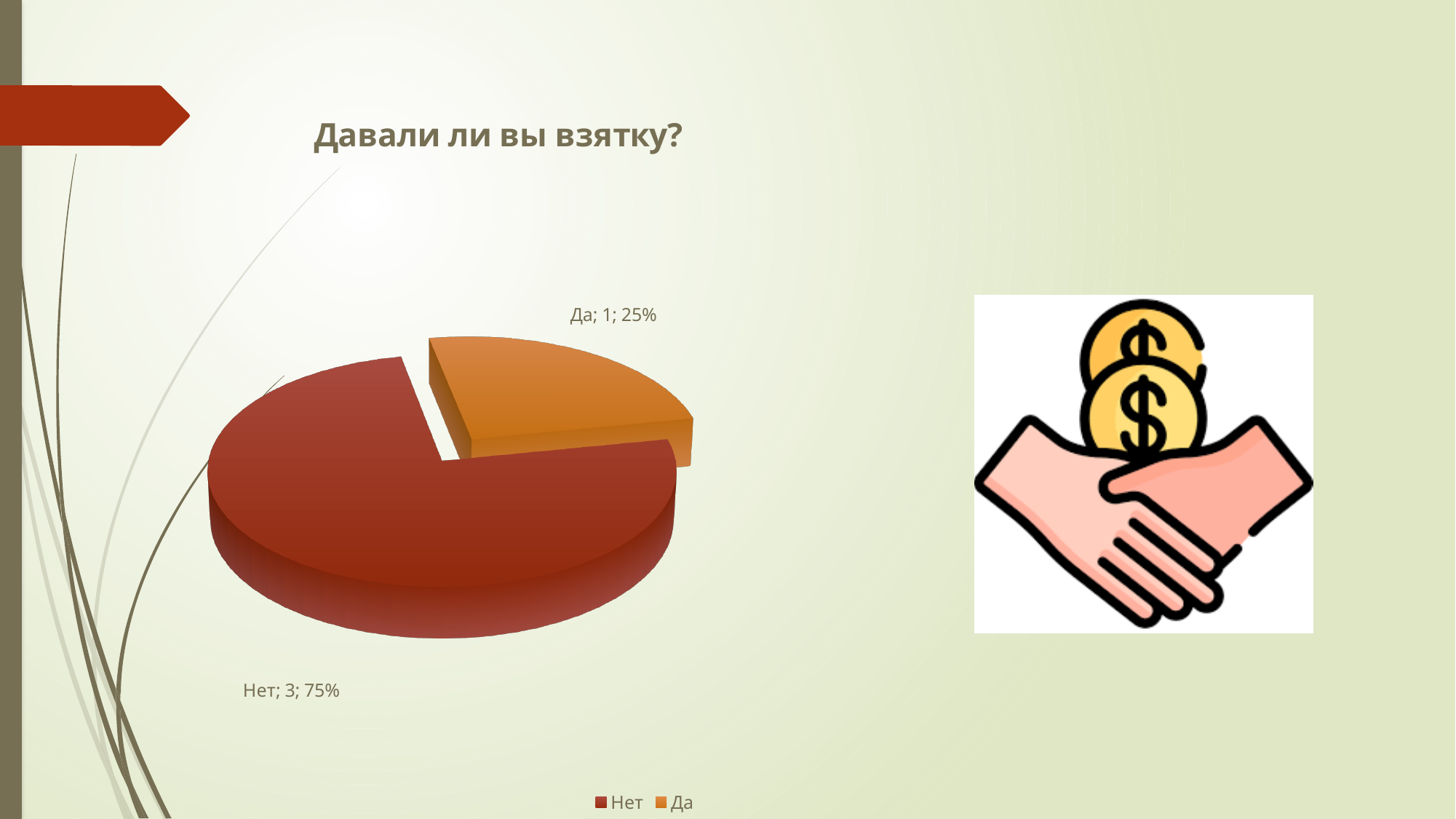
Which colour represents Да in the chart? orange What is the difference between the values for Нет and Да? 2 What is the value for Да? 1 What share of the pie does Нет represent? 75% What is the value for Нет? 3 What is the title of the chart? Давали ли вы взятку? How many entries does the legend list? 2 Which category has the smallest slice? Да Which category has the largest slice? Нет What kind of chart is shown on the slide? pie chart How many slices does the pie chart have? 2 What share of the pie does Да represent? 25%